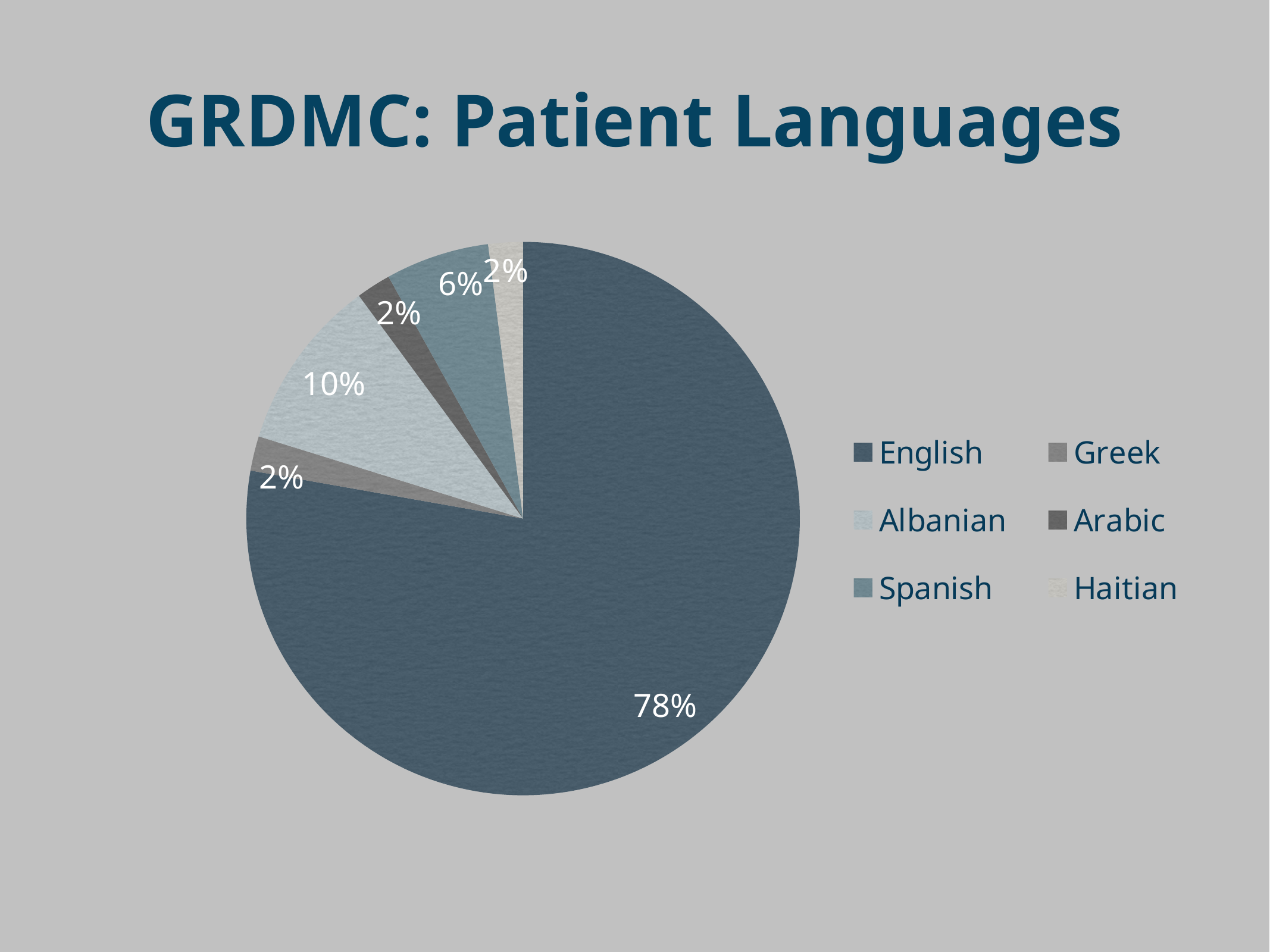
What share of the pie does Albanian account for? 10% What share of the pie does Spanish account for? 6% What share of the pie does Greek account for? 2% What is the difference in percentage points between the Spanish slice and the Arabic slice? 4 Which is larger, the Albanian slice or the Spanish slice? Albanian What kind of chart is shown on the slide? Pie chart Which language has the largest slice of the pie? English How many languages are shown in the pie chart? 6 What is the difference in percentage points between the English slice and the Albanian slice? 68 What is the title of the slide? GRDMC: Patient Languages